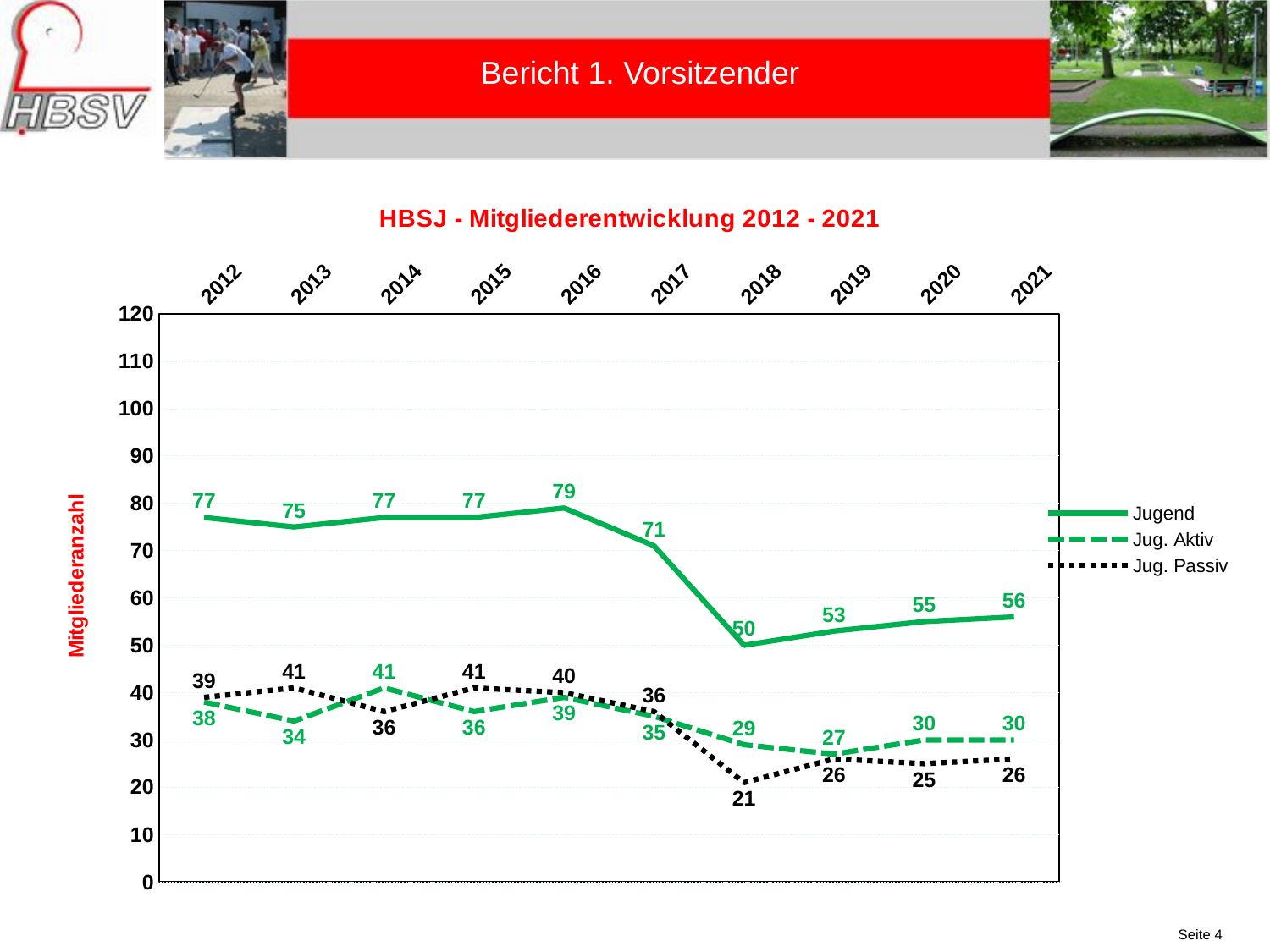
What type of chart is shown on the slide? line chart What is the title of the chart? HBSJ - Mitgliederentwicklung 2012 - 2021 How many series does the legend list? 3 What is the value of the Jugend series in 2016? 79 In which year is the Jugend series at its highest? 2016 In which year is the Jug. Passiv series at its lowest? 2018 What is the difference between the Jugend values in 2017 and 2018? 21 What is the value of the Jug. Passiv series in 2018? 21 How many years are plotted along the x axis? 10 Which is larger in 2013, Jug. Aktiv or Jug. Passiv? Jug. Passiv What is the value of the Jug. Aktiv series in 2014? 41 Does the Jugend series overall rise or fall from 2012 to 2021? fall